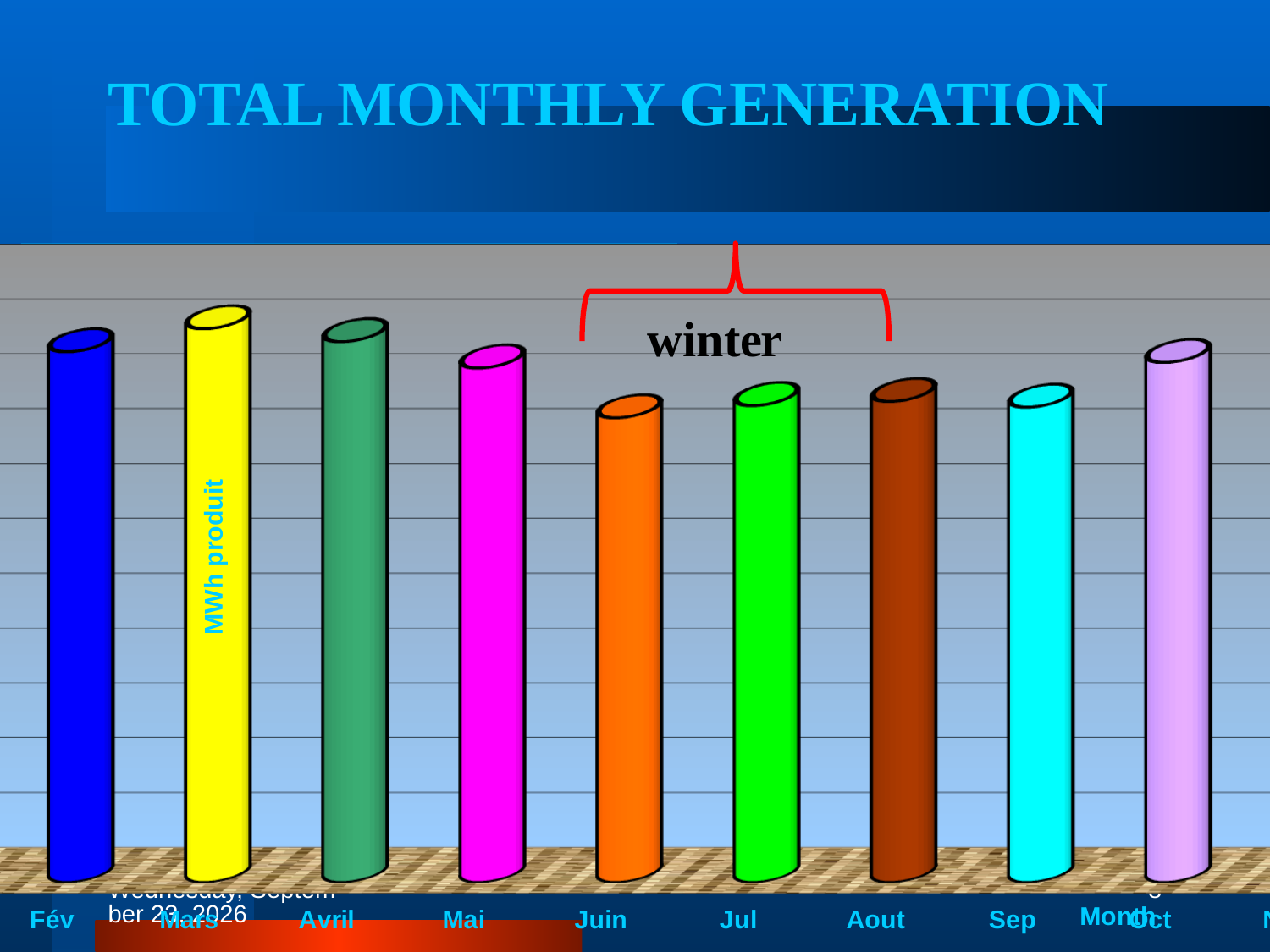
Which month has the highest value in the chart? Mars Which is larger, the value for Avril or the value for Aout? Avril Which is larger, the value for Mars or the value for Juin? Mars What is the title of the chart? TOTAL MONTHLY GENERATION Which is larger, the value for Oct or the value for Sep? Oct Which months does the red bracket labelled 'winter' span? Juin, Jul, Aout Do the values rise or fall from Mars to Juin? fall What is the label on the vertical axis of the chart? MWh produit What kind of chart is shown on the slide? bar chart